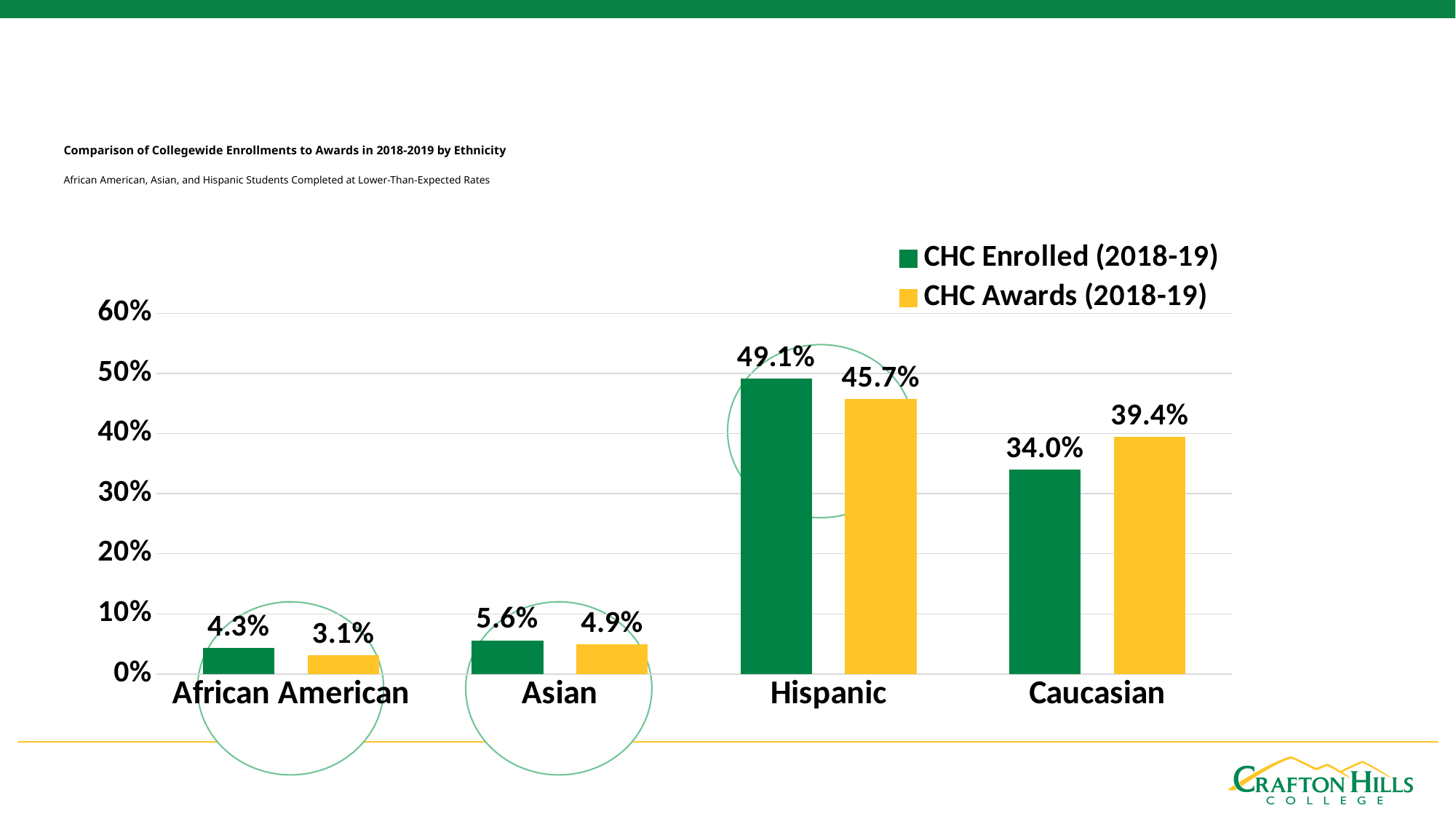
What is the CHC Awards (2018-19) value for Caucasian students? 39.4% What is the difference between the CHC Enrolled and CHC Awards values for Caucasian students? 5.4% Which ethnicity has the highest CHC Enrolled (2018-19) value? Hispanic How many series does the legend list? 2 What colour represents the CHC Awards (2018-19) series? Yellow What is the CHC Enrolled (2018-19) value for Hispanic students? 49.1% How many ethnicity categories are shown on the x axis? 4 For Asian students, which is larger: CHC Enrolled (2018-19) or CHC Awards (2018-19)? CHC Enrolled (2018-19) Which ethnicity has the lowest CHC Awards (2018-19) value? African American What is the difference between the CHC Enrolled and CHC Awards values for Hispanic students? 3.4% What kind of chart is shown on the slide? Bar chart What is the CHC Awards (2018-19) value for African American students? 3.1%